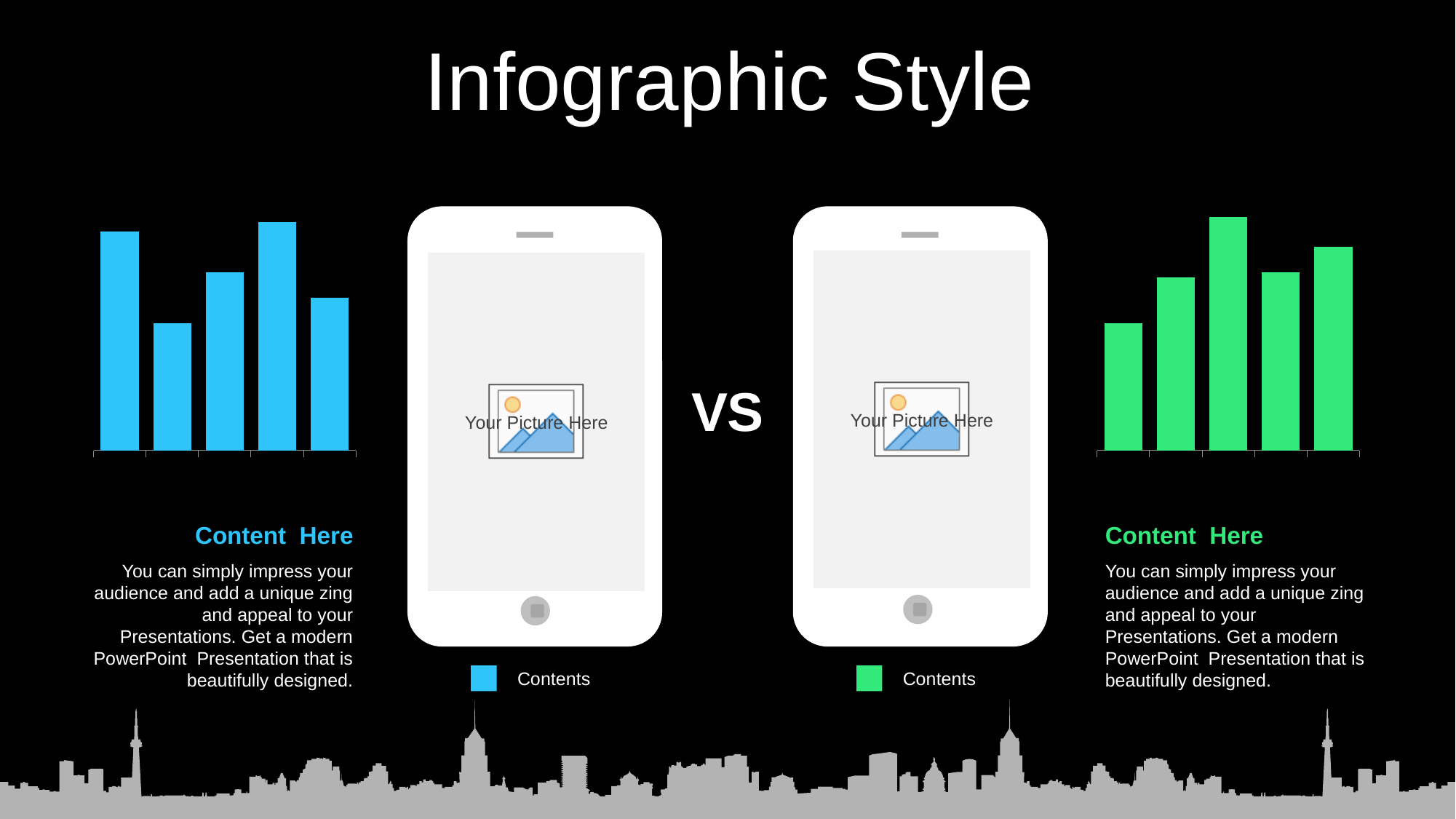
In the blue chart on the left, which bar is the tallest, counting from the left? the fourth bar What is the legend label shown beneath the left phone for the blue chart? Contents In the blue chart on the left, which is taller: the third bar or the fifth bar? the third bar In the green chart on the right, which is taller: the second bar or the fifth bar? the fifth bar In the green chart on the right, which bar is the tallest, counting from the left? the third bar What kind of chart is the green chart on the right side of the slide? bar chart What colour are the bars in the chart on the right side of the slide? green How many bars does the blue chart on the left have? 5 In the blue chart on the left, which bar is the shortest, counting from the left? the second bar What kind of chart is the blue chart on the left side of the slide? bar chart In the green chart on the right, which bar is the shortest, counting from the left? the first bar How many bars does the green chart on the right have? 5